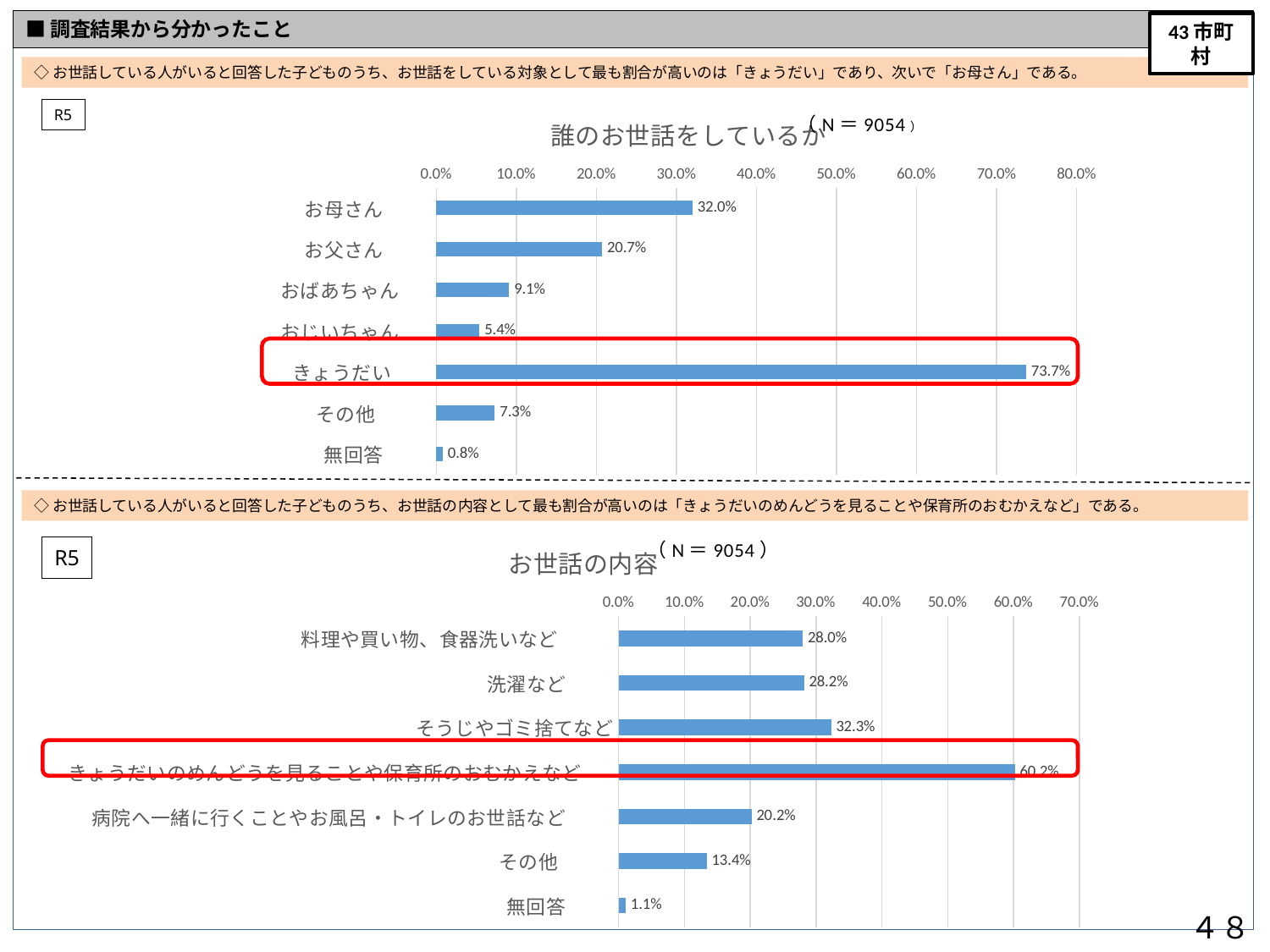
In the chart titled 「お世話の内容」, what is the value for 病院へ一緒に行くことやお風呂・トイレのお世話など? 20.2% In the chart titled 「誰のお世話をしているか」, what is the value for お母さん? 32.0% In the chart titled 「誰のお世話をしているか」, which category has the lowest value? 無回答 In the chart titled 「お世話の内容」, what kind of chart is it? Bar chart In the chart titled 「誰のお世話をしているか」, which category has the highest value? きょうだい In the chart titled 「お世話の内容」, what is the difference between the values for きょうだいのめんどうを見ることや保育所のおむかえなど and そうじやゴミ捨てなど? 27.9% What is the N value shown next to the title of the chart 「お世話の内容」? 9054 In the chart titled 「お世話の内容」, what is the value for そうじやゴミ捨てなど? 32.3% In the chart titled 「誰のお世話をしているか」, which is larger, the value for おばあちゃん or the value for その他? おばあちゃん In the chart titled 「誰のお世話をしているか」, what is the difference between the values for お母さん and お父さん? 11.3% In the chart titled 「誰のお世話をしているか」, how many categories are plotted? 7 In the chart titled 「お世話の内容」, which category has the highest value? きょうだいのめんどうを見ることや保育所のおむかえなど